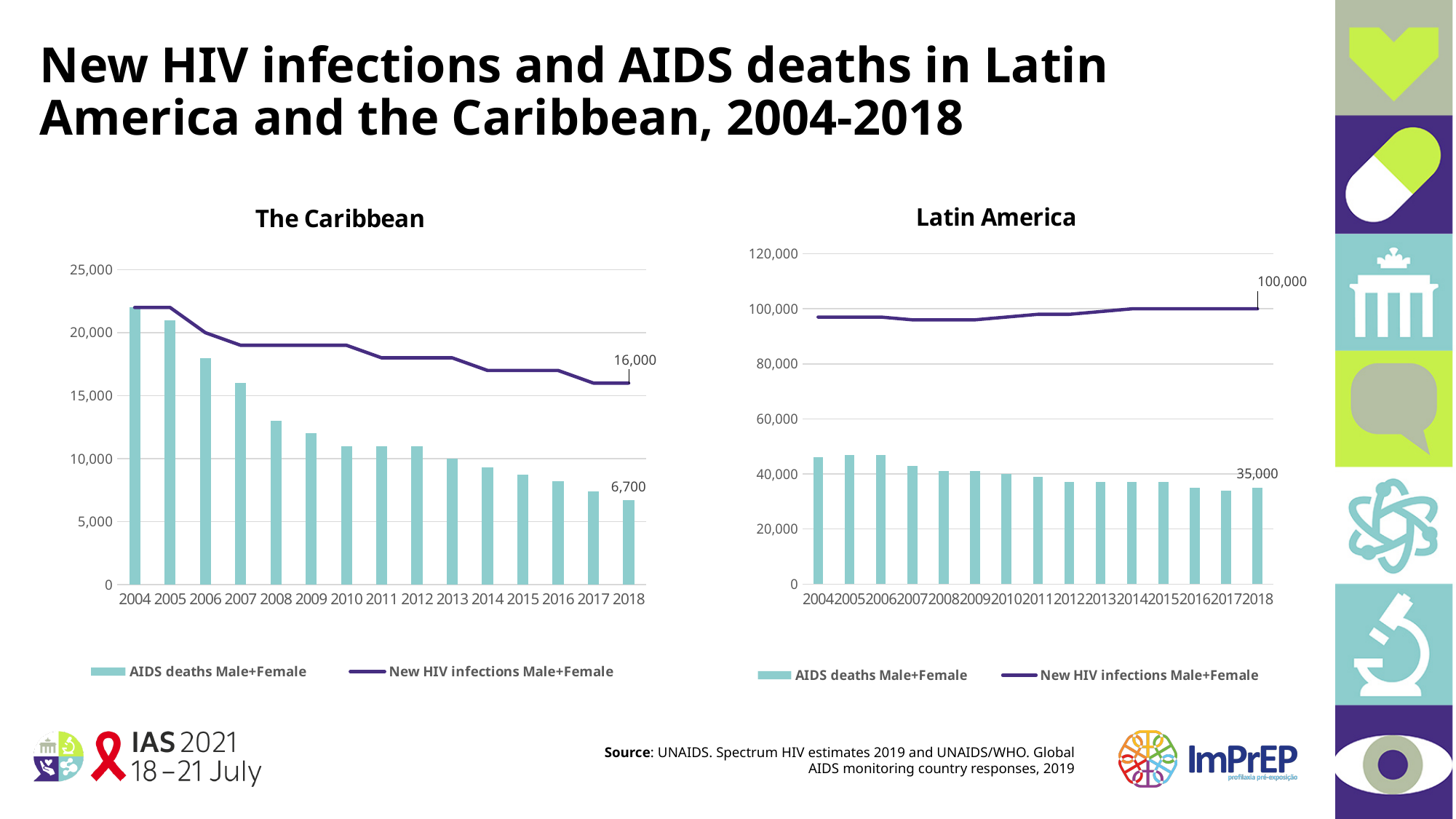
In the Caribbean chart, which series is drawn as a line? New HIV infections Male+Female In the Caribbean chart, is the value of AIDS deaths Male+Female in 2004 greater or less than 20,000? greater In the Caribbean chart, which year has the highest AIDS deaths Male+Female? 2004 In the Caribbean chart, do New HIV infections Male+Female rise or fall from 2004 to 2018? fall In the Caribbean chart, what is the value of AIDS deaths Male+Female in 2018? 6,700 In the Caribbean chart, what is the value of New HIV infections Male+Female in 2018? 16,000 In the Latin America chart, what is the value of AIDS deaths Male+Female in 2018? 35,000 In the Latin America chart, how many years are shown on the x axis? 15 In the Latin America chart, what is the value of New HIV infections Male+Female in 2018? 100,000 In the Latin America chart, is the value of AIDS deaths Male+Female in 2004 greater or less than 40,000? greater In the Caribbean chart, which year has the lowest AIDS deaths Male+Female? 2018 In the Caribbean chart, how many series does the legend list? 2